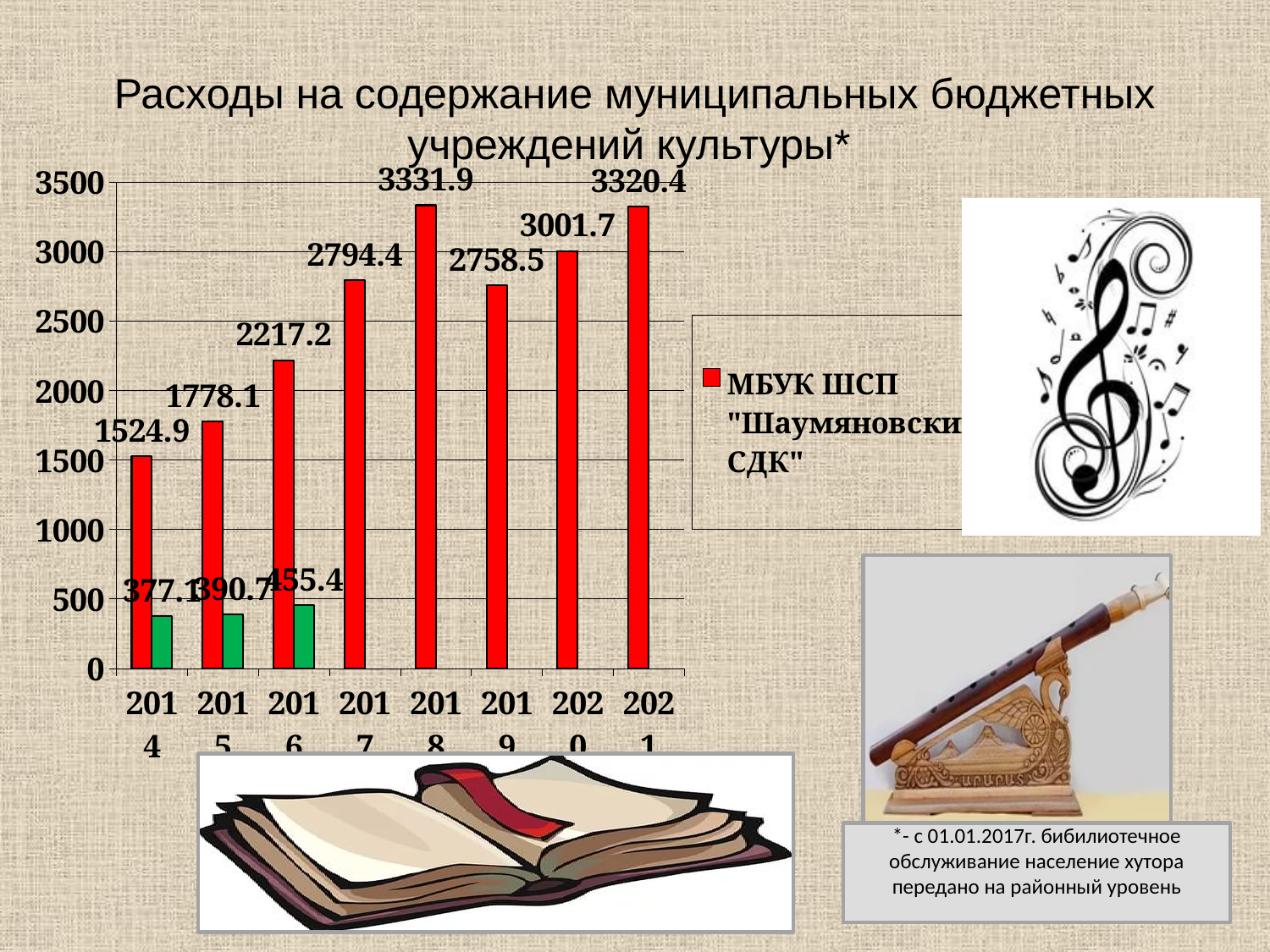
In which year is the red bar highest? 2018 What is the value of the green bar for 2016? 455.4 Do the red bar values rise or fall from 2014 to 2018? rise In which year is the red bar lowest? 2014 What is the value of the red bar for 2014? 1524.9 What kind of chart is shown on the slide? bar chart What is the value of the red bar for 2018? 3331.9 Is the red bar value for 2017 greater or less than 2500? greater Which year has the larger red bar value, 2018 or 2021? 2018 What is the difference between the red bar values for 2021 and 2020? 318.7 How many years are shown on the x axis? 8 What is the difference between the red bar values for 2016 and 2015? 439.1